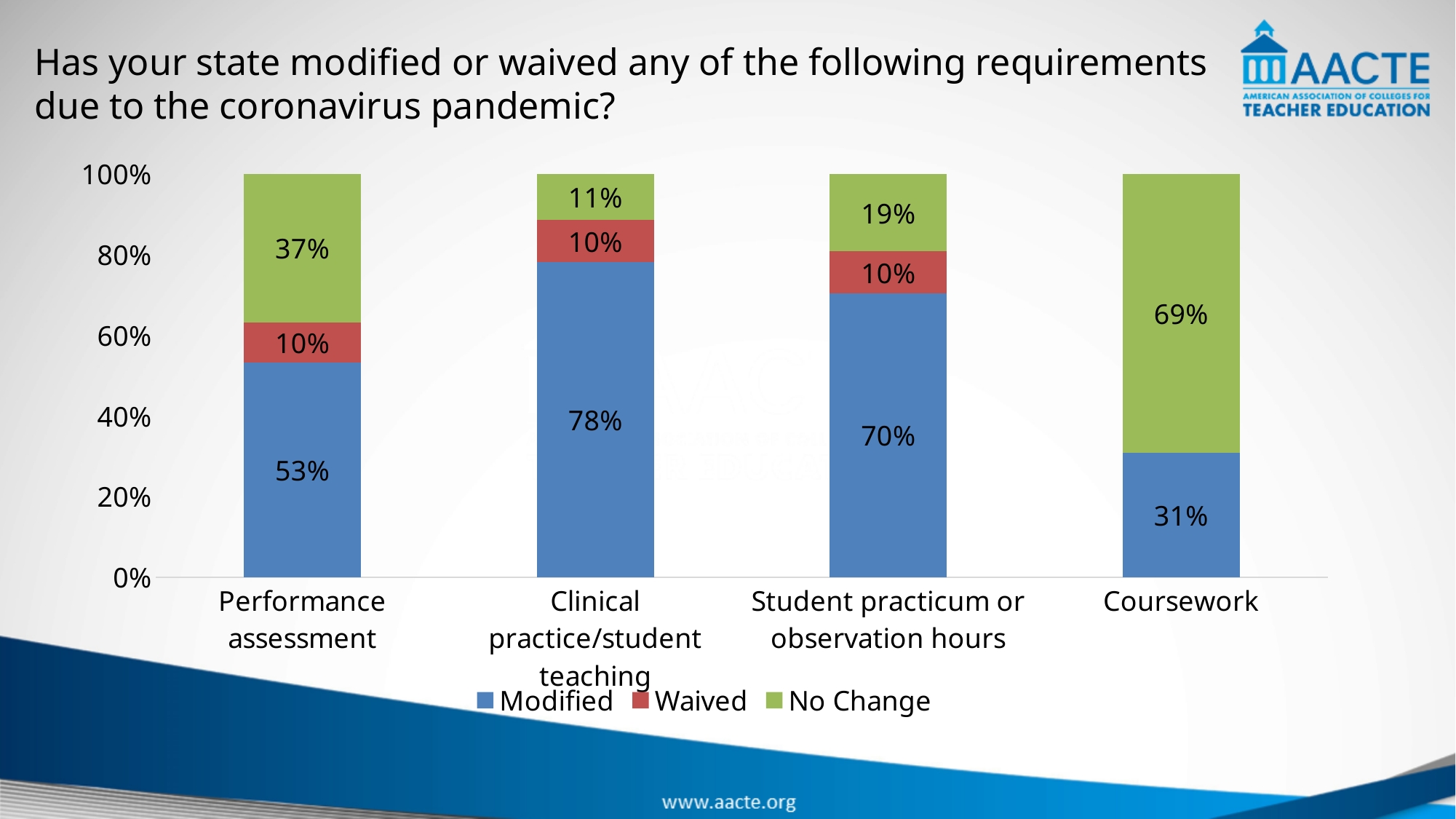
What is the difference between the 'No Change' values for Coursework and Performance assessment? 32% Which category has the highest 'Modified' percentage? Clinical practice/student teaching What is the 'No Change' value for Coursework? 69% How many categories are shown on the x axis? 4 What percentage of states modified the performance assessment requirement? 53% Which category has the lowest 'Modified' percentage? Coursework What is the 'Modified' value for Clinical practice/student teaching? 78% How many series does the legend list? 3 What is the 'Waived' value for Student practicum or observation hours? 10% Which colour represents the 'Waived' series? Red Is the 'Modified' value larger for Student practicum or observation hours or for Performance assessment? Student practicum or observation hours What kind of chart is shown on the slide? Stacked bar chart